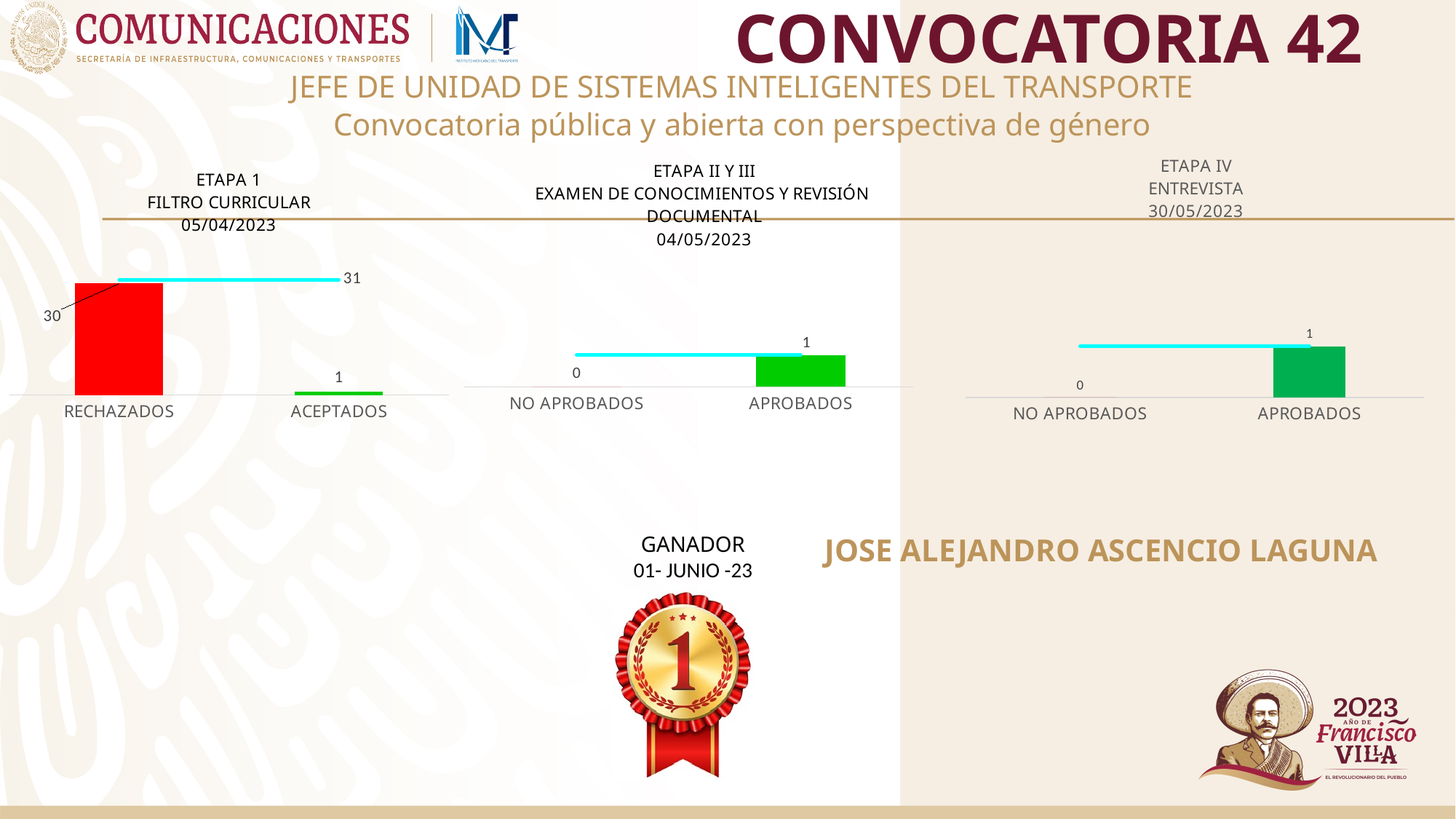
What kind of chart is the ETAPA 1 FILTRO CURRICULAR chart? Combination bar and line chart In the ETAPA IV ENTREVISTA chart, what is the value for APROBADOS? 1 How many categories are shown in the ETAPA IV ENTREVISTA chart? 2 In the ETAPA II Y III EXAMEN DE CONOCIMIENTOS Y REVISIÓN DOCUMENTAL chart, what is the value for APROBADOS? 1 In the ETAPA IV ENTREVISTA chart, which category has the lowest value? NO APROBADOS In the ETAPA 1 FILTRO CURRICULAR chart, what value is labelled on the cyan line? 31 In the ETAPA 1 FILTRO CURRICULAR chart, what is the difference between RECHAZADOS and ACEPTADOS? 29 In the ETAPA 1 FILTRO CURRICULAR chart, which category has the highest value? RECHAZADOS In the ETAPA 1 FILTRO CURRICULAR chart, what is the value for RECHAZADOS? 30 In the ETAPA 1 FILTRO CURRICULAR chart, what is the value for ACEPTADOS? 1 In the ETAPA II Y III EXAMEN DE CONOCIMIENTOS Y REVISIÓN DOCUMENTAL chart, what is the value for NO APROBADOS? 0 In the ETAPA 1 FILTRO CURRICULAR chart, what colour is the RECHAZADOS bar? Red